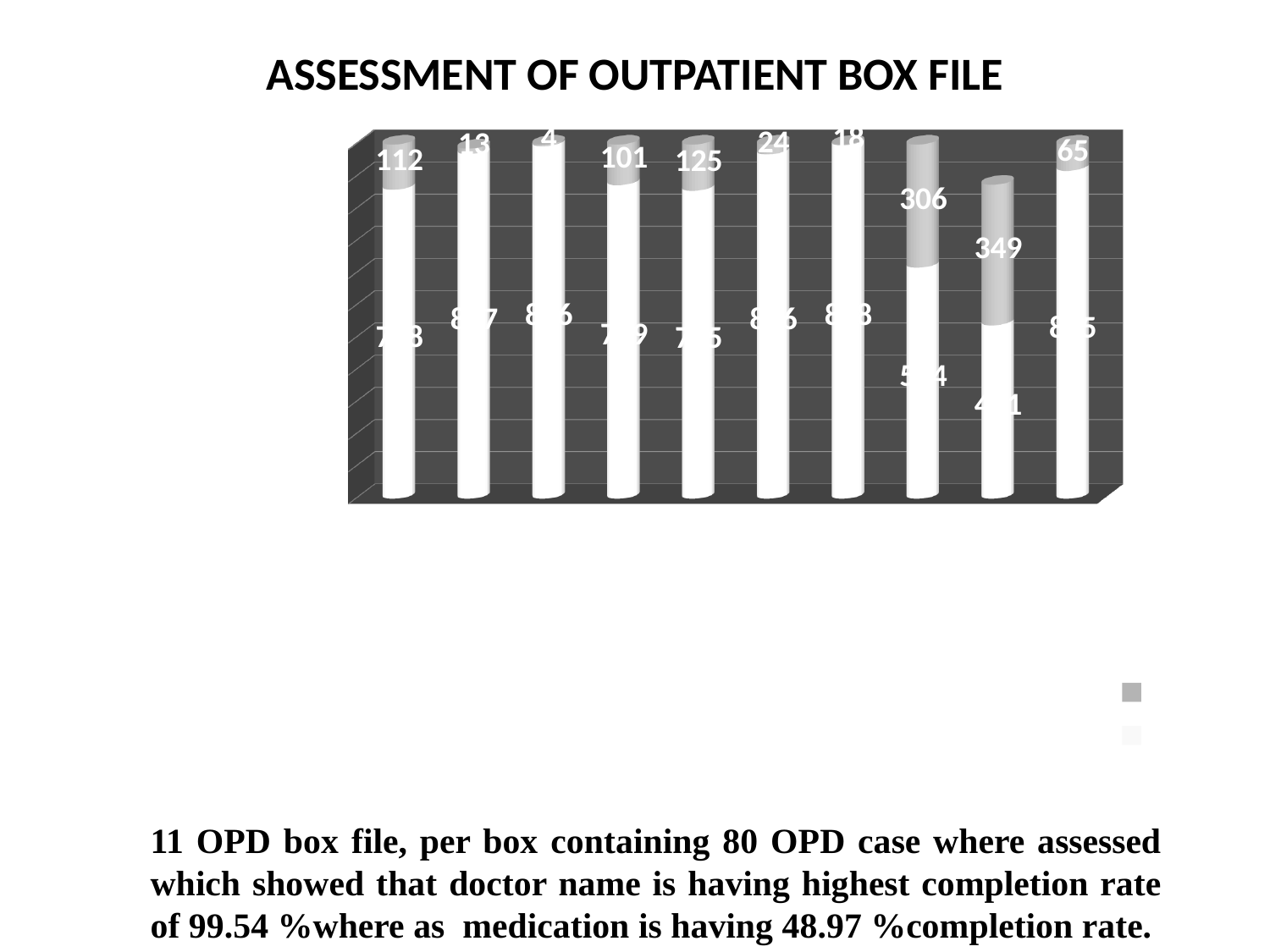
What value is labelled on the grey upper segment of the fourth bar from the left? 101 How many bars are plotted in the chart? 10 Which has the larger grey upper segment value, the eighth bar from the left or the ninth bar from the left? the ninth bar What value is labelled on the grey upper segment of the rightmost bar? 65 What value is labelled on the grey upper segment of the leftmost bar? 112 What is the difference between the grey upper segment values of the ninth bar (349) and the eighth bar (306)? 43 What is the title of the chart? ASSESSMENT OF OUTPATIENT BOX FILE What kind of chart is shown on the slide? bar chart What is the largest value labelled on any grey upper segment? 349 What is the smallest value labelled on any grey upper segment? 4 How many series does the legend show? 2 What value is labelled on the grey upper segment of the fifth bar from the left? 125